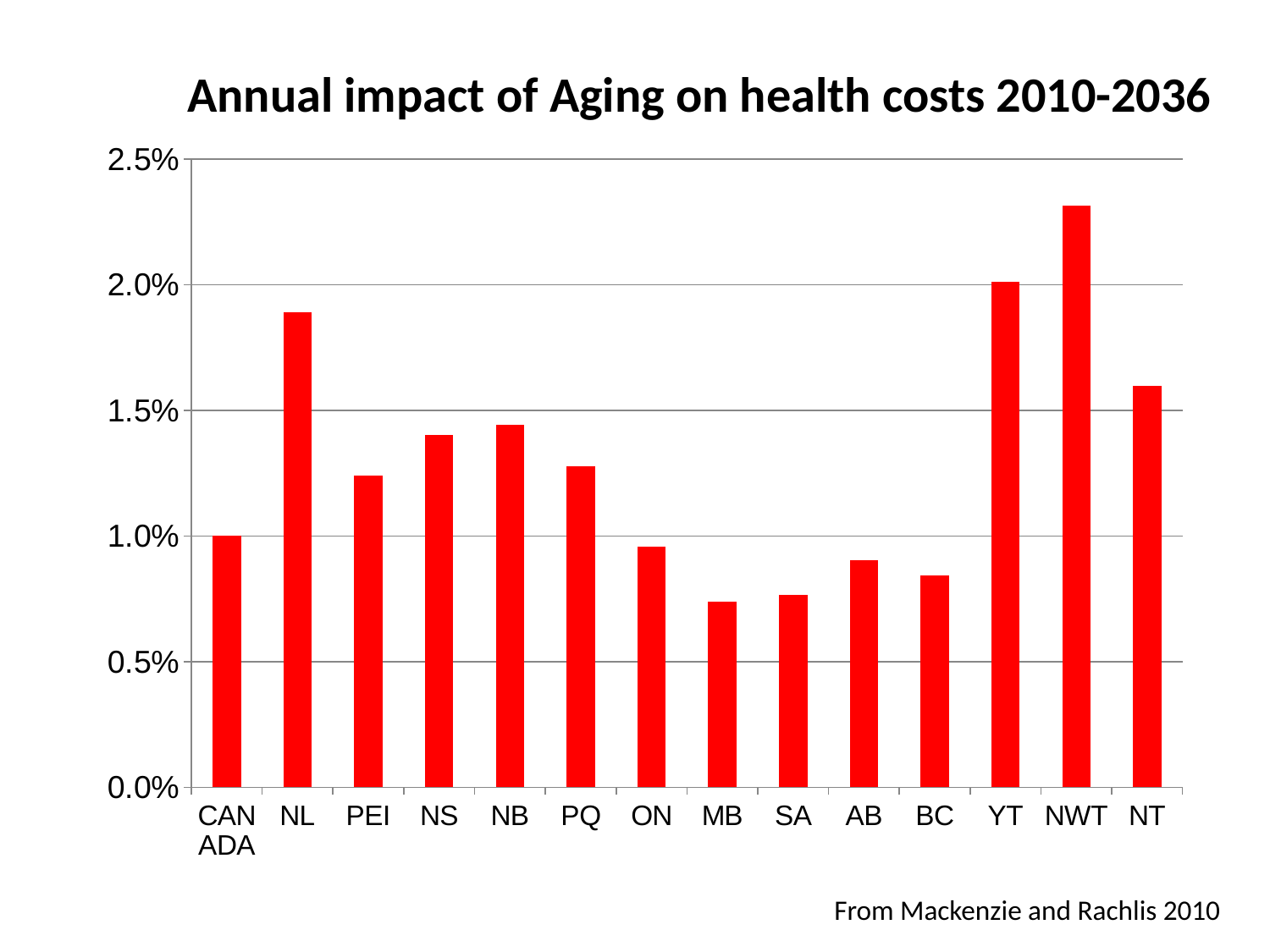
Which category has the highest value in the chart? NWT How many categories are shown on the x axis of the chart? 14 Is the value for PEI greater or less than 1.5%? less Which is larger, the value for NS or the value for PQ? NS What is the title of the chart? Annual impact of Aging on health costs 2010-2036 According to the note on the slide, what is the source of the chart data? Mackenzie and Rachlis 2010 What is the value for CANADA? 1.0% Which is larger, the value for NL or the value for NT? NL Is the value for BC greater or less than 1.0%? less What kind of chart is shown on the slide? bar chart Is the value for NL greater or less than 1.5%? greater